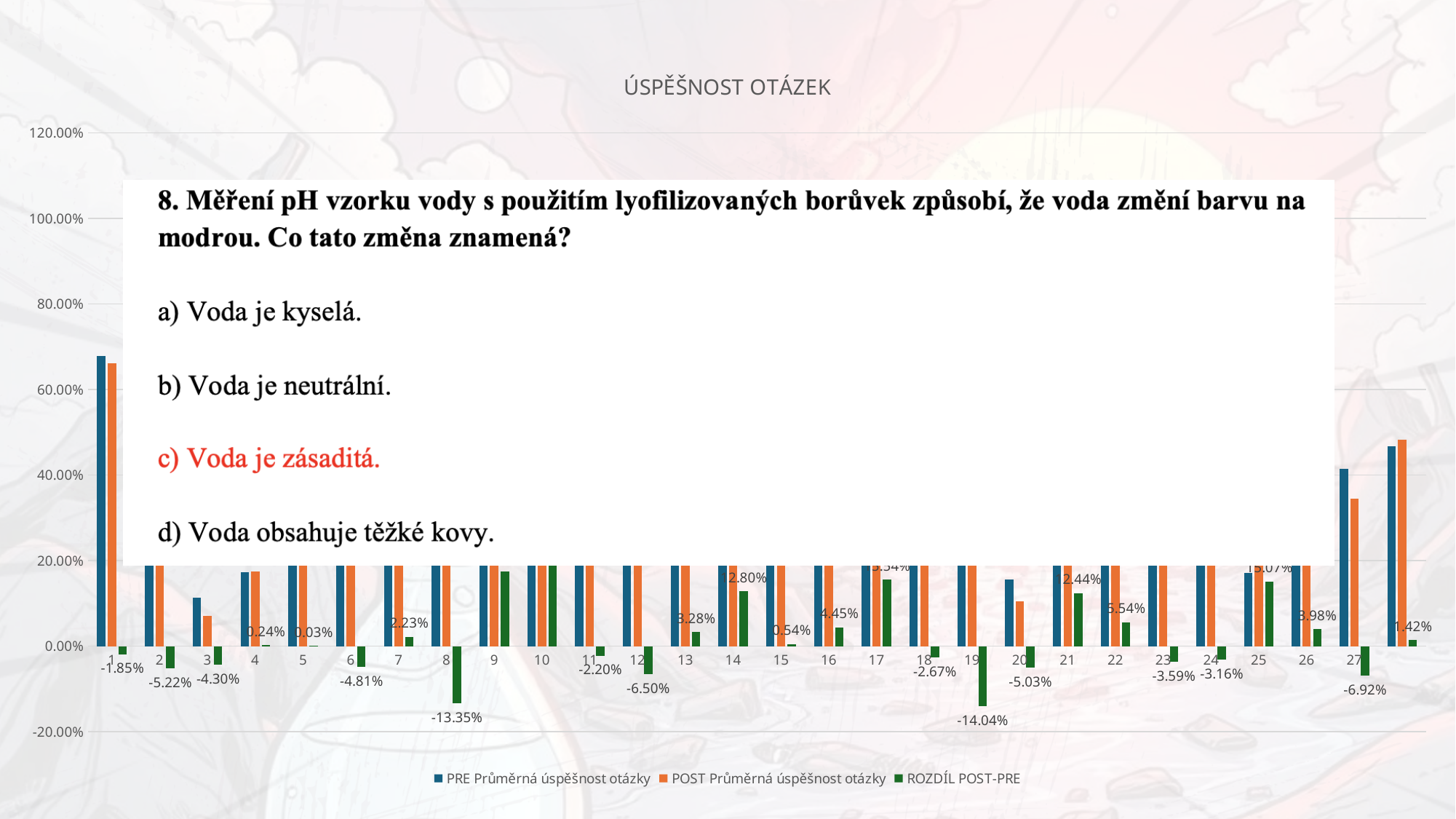
Which series is shown in green in the legend? ROZDÍL POST-PRE Is the PRE Průměrná úspěšnost otázky value for question 1 greater or less than 60.00%? greater What is the ROZDÍL POST-PRE value for question 27? -6.92% How many series does the legend list? 3 What is the difference between the ROZDÍL POST-PRE values for question 22 and question 16? 1.09% What is the ROZDÍL POST-PRE value for question 16? 4.45% What is the title of the chart? ÚSPĚŠNOST OTÁZEK What is the ROZDÍL POST-PRE value for question 19? -14.04% Which question has the lowest ROZDÍL POST-PRE value? 19 For question 27, which is larger: the PRE Průměrná úspěšnost otázky value or the POST Průměrná úspěšnost otázky value? PRE Průměrná úspěšnost otázky What kind of chart is shown on the slide? bar chart What is the ROZDÍL POST-PRE value for question 8? -13.35%